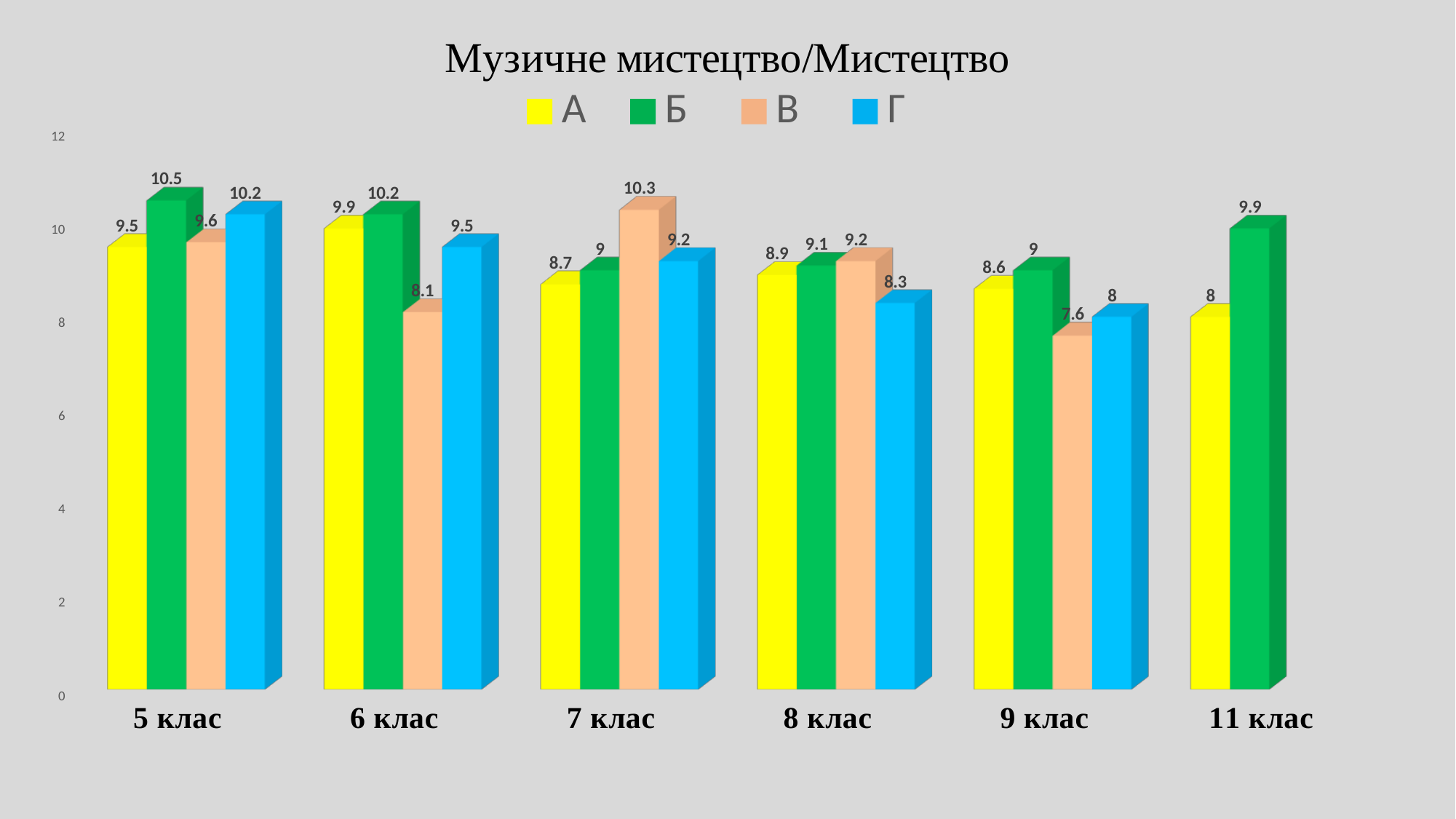
What is the title of the chart? Музичне мистецтво/Мистецтво Which is larger in 6 клас: series А or series Г? А What is the value for series Г in 8 клас? 8.3 What is the value for series Б in 5 клас? 10.5 What is the difference between series Б and series А in 11 клас? 1.9 What is the value for series В in 6 клас? 8.1 How many series does the legend list? 4 Which series has the lowest value in 9 клас? В How many class categories are shown on the x axis? 6 What kind of chart is shown on the slide? bar chart What is the value for series А in 11 клас? 8 Which series has the highest value in 7 клас? В